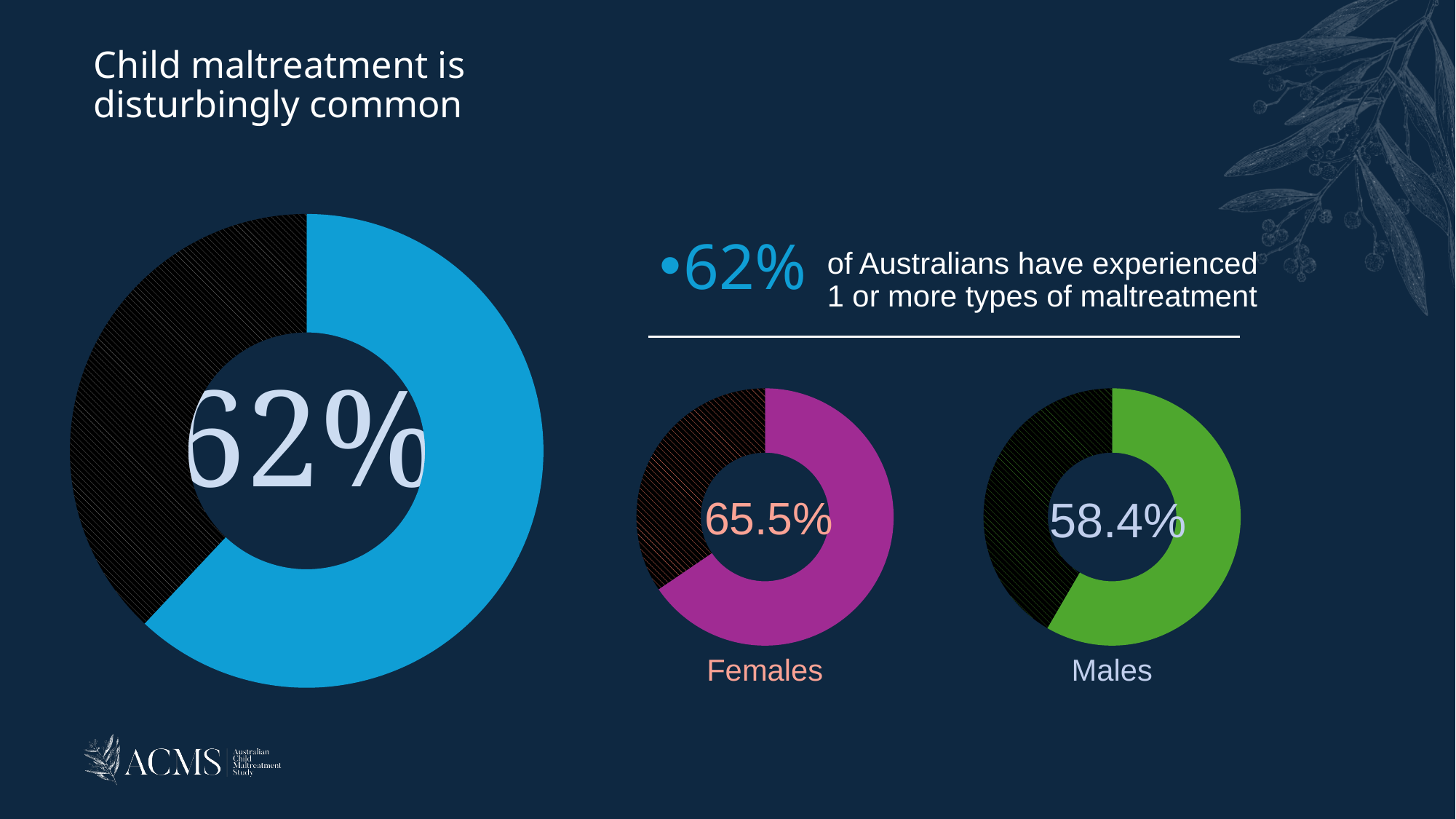
What value is shown in the Males donut chart? 58.4% What value is shown in the Females donut chart? 65.5% What colour is the filled segment of the Males donut chart? Green Which of the two smaller donut charts, Females or Males, shows the higher value? Females In the large donut chart on the left, what share of the ring is filled by the blue segment? 62% In the large donut chart on the left, what share of the ring is the dark, unfilled segment? 38% What is the difference between the Females value and the Males value in the two smaller donut charts? 7.1 percentage points What colour is the filled segment of the Females donut chart? Purple (magenta) Is the value shown in the Males donut chart greater or less than 60%? less What value is shown in the centre of the large donut chart on the left of the slide? 62% What kind of chart is used to show the 62% figure on the left of the slide? Donut (pie) chart How many donut charts are shown on the slide? 3